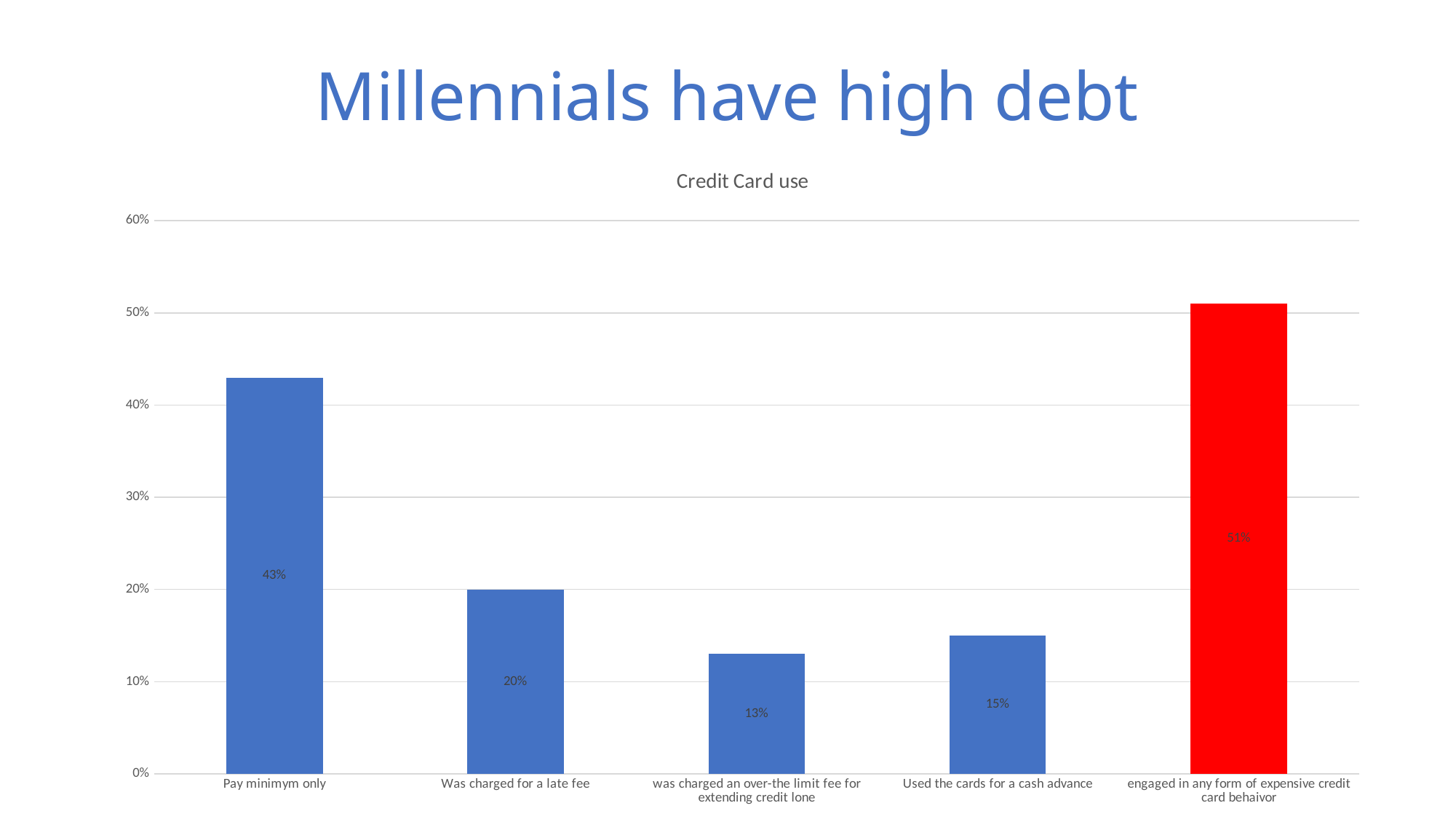
What is the value for 'Was charged for a late fee'? 20% How many categories are shown in the chart? 5 What is the difference between the values for 'engaged in any form of expensive credit card behaivor' and 'Pay minimym only'? 8% What kind of chart is shown on the slide? bar chart What is the value for 'Used the cards for a cash advance'? 15% What is the value for 'Pay minimym only'? 43% Is the value for 'Pay minimym only' greater or less than 40%? greater What is the value for 'engaged in any form of expensive credit card behaivor'? 51% Which category has the lowest value? was charged an over-the limit fee for extending credit lone What is the title of the chart? Credit Card use Which category has the highest value? engaged in any form of expensive credit card behaivor Which is larger, the value for 'Was charged for a late fee' or 'Used the cards for a cash advance'? Was charged for a late fee